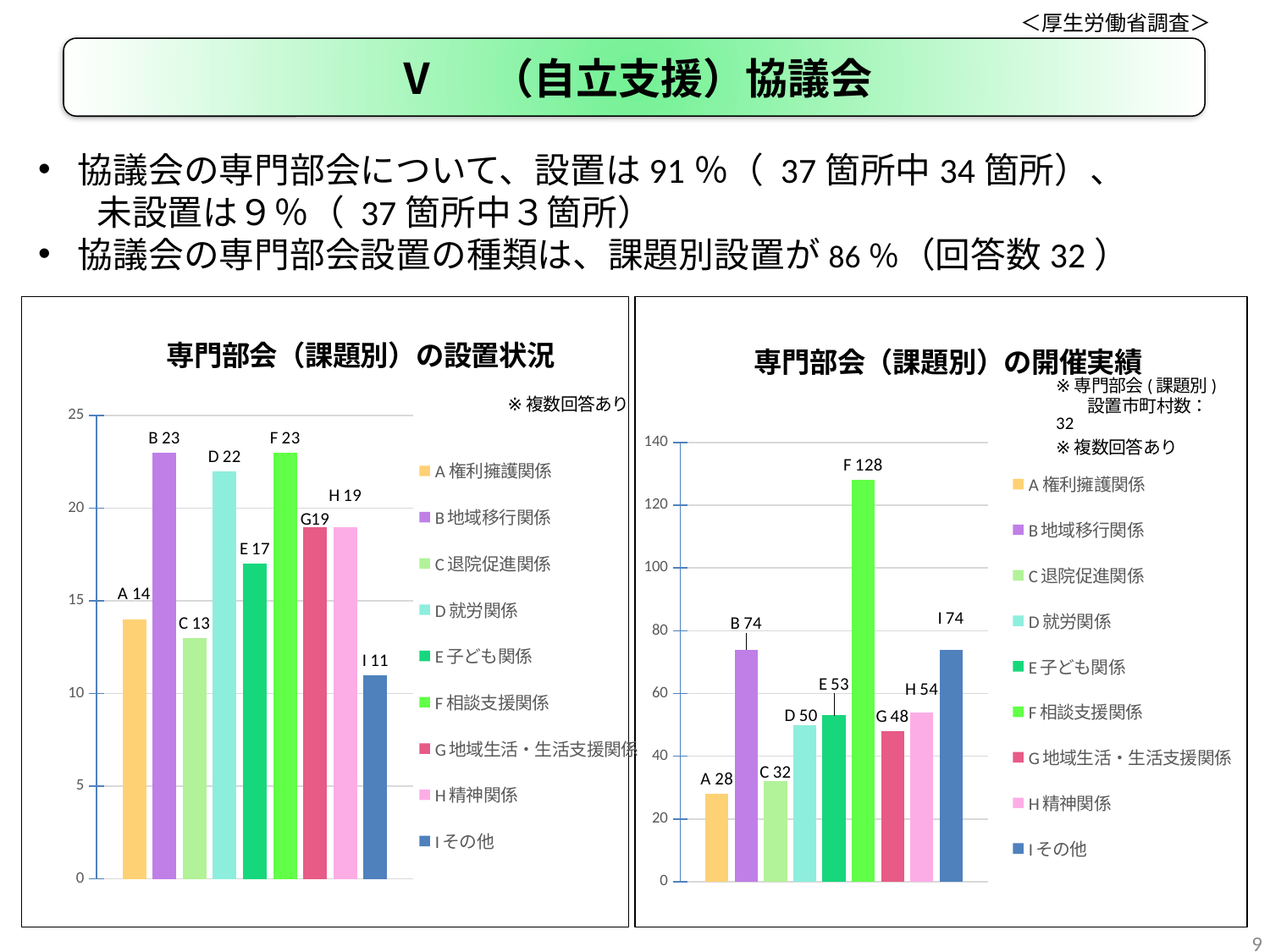
In the chart titled 専門部会（課題別）の設置状況, what is the difference between the values for B 地域移行関係 and A 権利擁護関係? 9 What kind of chart is the chart titled 専門部会（課題別）の開催実績? Bar chart In the chart titled 専門部会（課題別）の設置状況, which category has the lowest value? I その他 In the chart titled 専門部会（課題別）の開催実績, which category has the lowest value? A 権利擁護関係 In the chart titled 専門部会（課題別）の設置状況, what is the value for D 就労関係? 22 In the chart titled 専門部会（課題別）の開催実績, which category has the highest value? F 相談支援関係 In the chart titled 専門部会（課題別）の開催実績, which is larger, the value for E 子ども関係 or the value for G 地域生活・生活支援関係? E 子ども関係 In the chart titled 専門部会（課題別）の開催実績, what is the difference between the values for I その他 and C 退院促進関係? 42 In the chart titled 専門部会（課題別）の開催実績, what is the value for F 相談支援関係? 128 In the chart titled 専門部会（課題別）の設置状況, what is the value for E 子ども関係? 17 In the chart titled 専門部会（課題別）の開催実績, what is the value for H 精神関係? 54 In the chart titled 専門部会（課題別）の設置状況, how many categories are plotted? 9